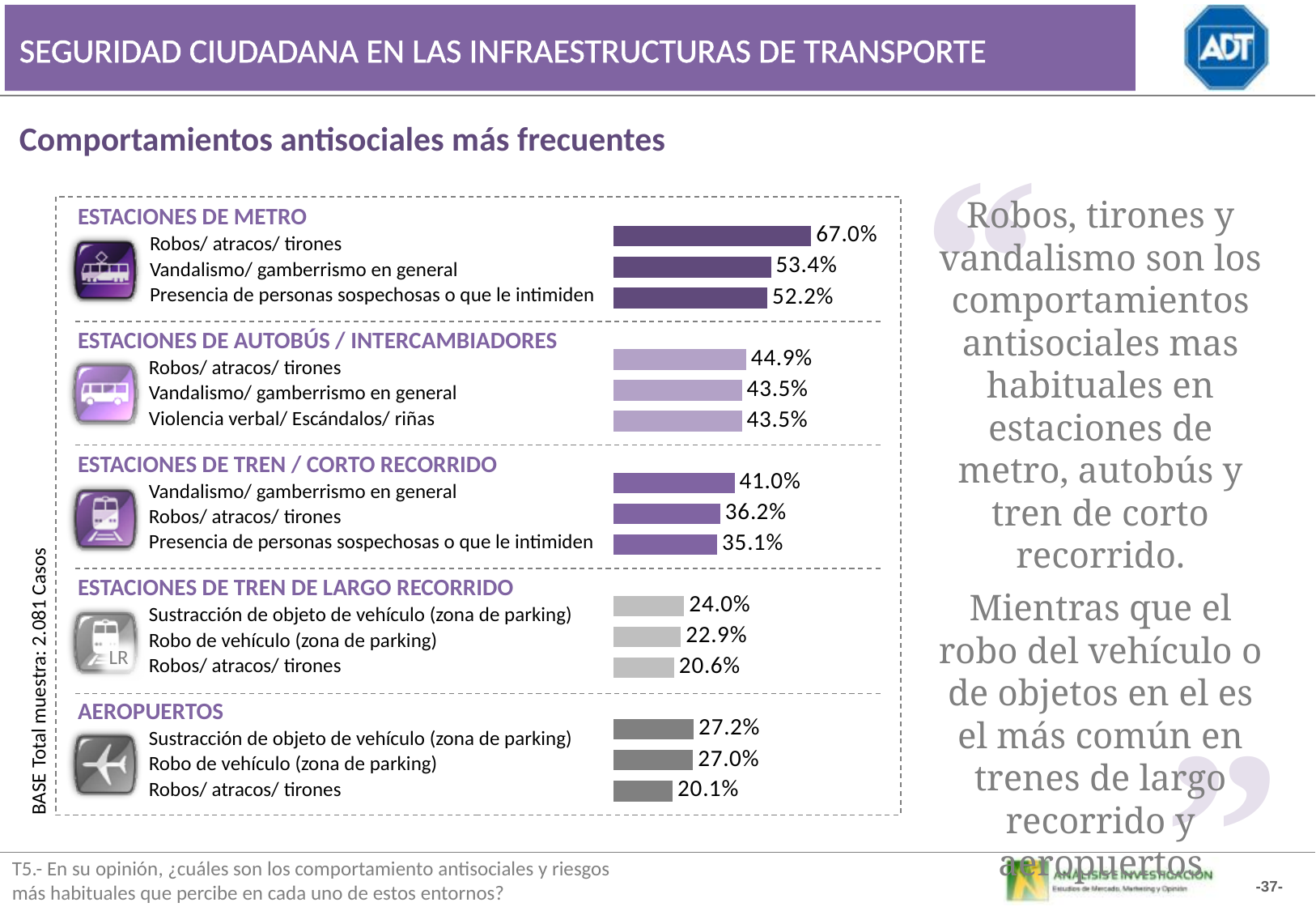
How many bars are plotted on the chart in total? 15 What is the value for 'Robos/ atracos/ tirones' in the Estaciones de Metro section? 67.0% What is the difference between 'Robos/ atracos/ tirones' and 'Vandalismo/ gamberrismo en general' in the Estaciones de Metro section? 13.6% How many transport environment sections does the chart show? 5 What is the value for 'Violencia verbal/ Escándalos/ riñas' in the Estaciones de Autobús / Intercambiadores section? 43.5% What is the value for 'Vandalismo/ gamberrismo en general' in the Estaciones de Tren / Corto Recorrido section? 41.0% What is the title of the chart? Comportamientos antisociales más frecuentes What kind of chart is shown on the slide? Bar chart Which bar has the lowest value on the whole chart? Robos/ atracos/ tirones (Aeropuertos) Which is larger: 'Sustracción de objeto de vehículo (zona de parking)' in Estaciones de Tren de Largo Recorrido or in Aeropuertos? Aeropuertos Which bar has the highest value on the whole chart? Robos/ atracos/ tirones (Estaciones de Metro) What is the value for 'Robo de vehículo (zona de parking)' in the Aeropuertos section? 27.0%